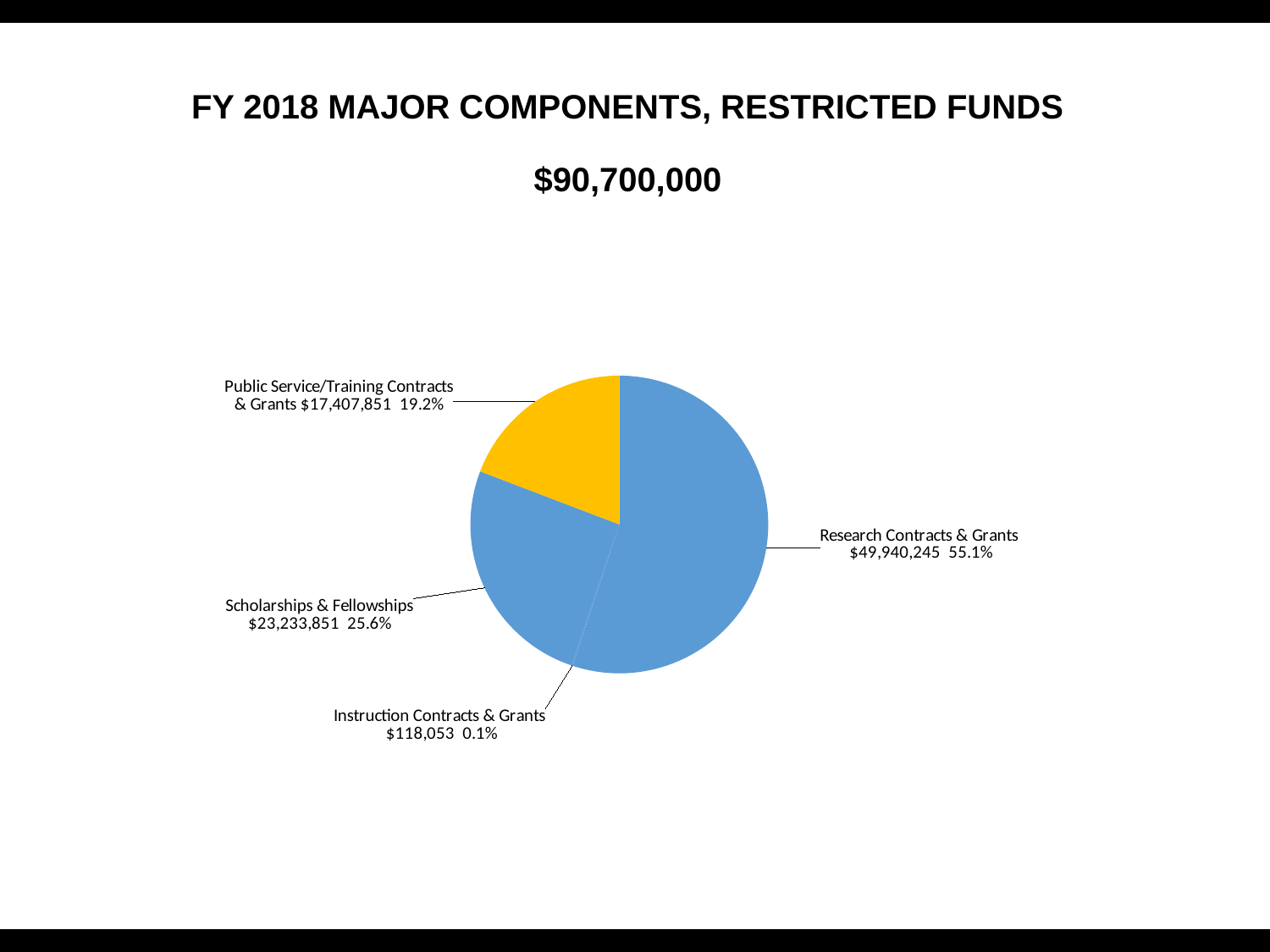
What is the value for Research Contracts & Grants? $49,940,245 What is the value for Instruction Contracts & Grants? $118,053 How many categories are shown in the pie chart? 4 Which category has the smallest slice of the pie? Instruction Contracts & Grants What total amount is shown below the chart title? $90,700,000 What kind of chart is shown on the slide? Pie chart Which is larger, Scholarships & Fellowships or Public Service/Training Contracts & Grants? Scholarships & Fellowships What is the difference in value between Scholarships & Fellowships and Public Service/Training Contracts & Grants? $5,826,000 What percentage share does Scholarships & Fellowships have? 25.6% Which category has the largest slice of the pie? Research Contracts & Grants What is the difference in value between Research Contracts & Grants and Scholarships & Fellowships? $26,706,394 What is the value for Public Service/Training Contracts & Grants? $17,407,851